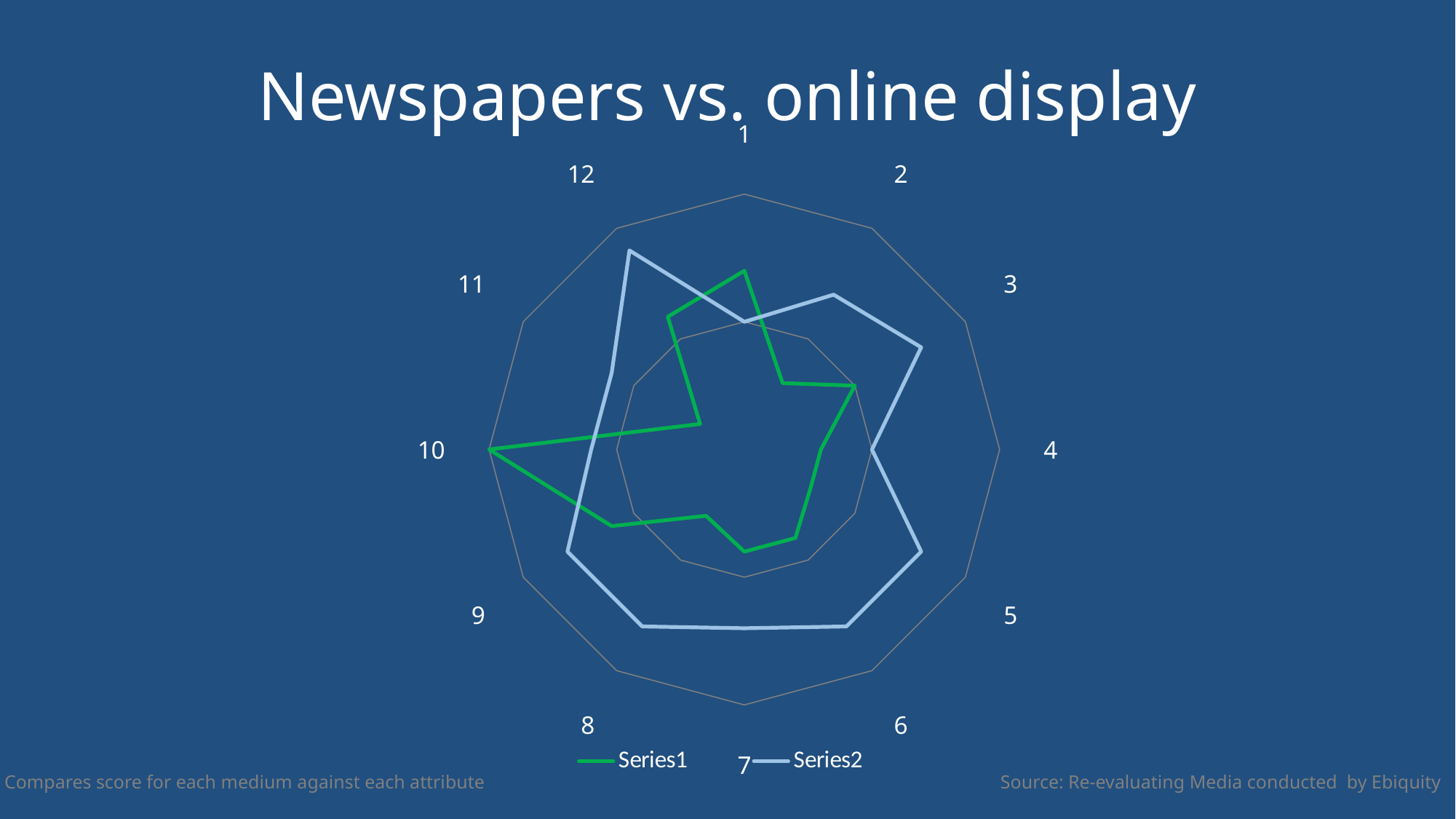
At category 5, which series has the larger value, Series1 or Series2? Series2 How many series does the legend list? 2 At category 10, which series has the larger value, Series1 or Series2? Series1 At category 7, which series has the larger value, Series1 or Series2? Series2 How many categories (axes) does the radar chart have? 12 What kind of chart is shown on the slide? Radar chart What is the title of the chart on the slide? Newspapers vs. online display Which series is drawn in green? Series1 For Series1, which category has the highest value? 10